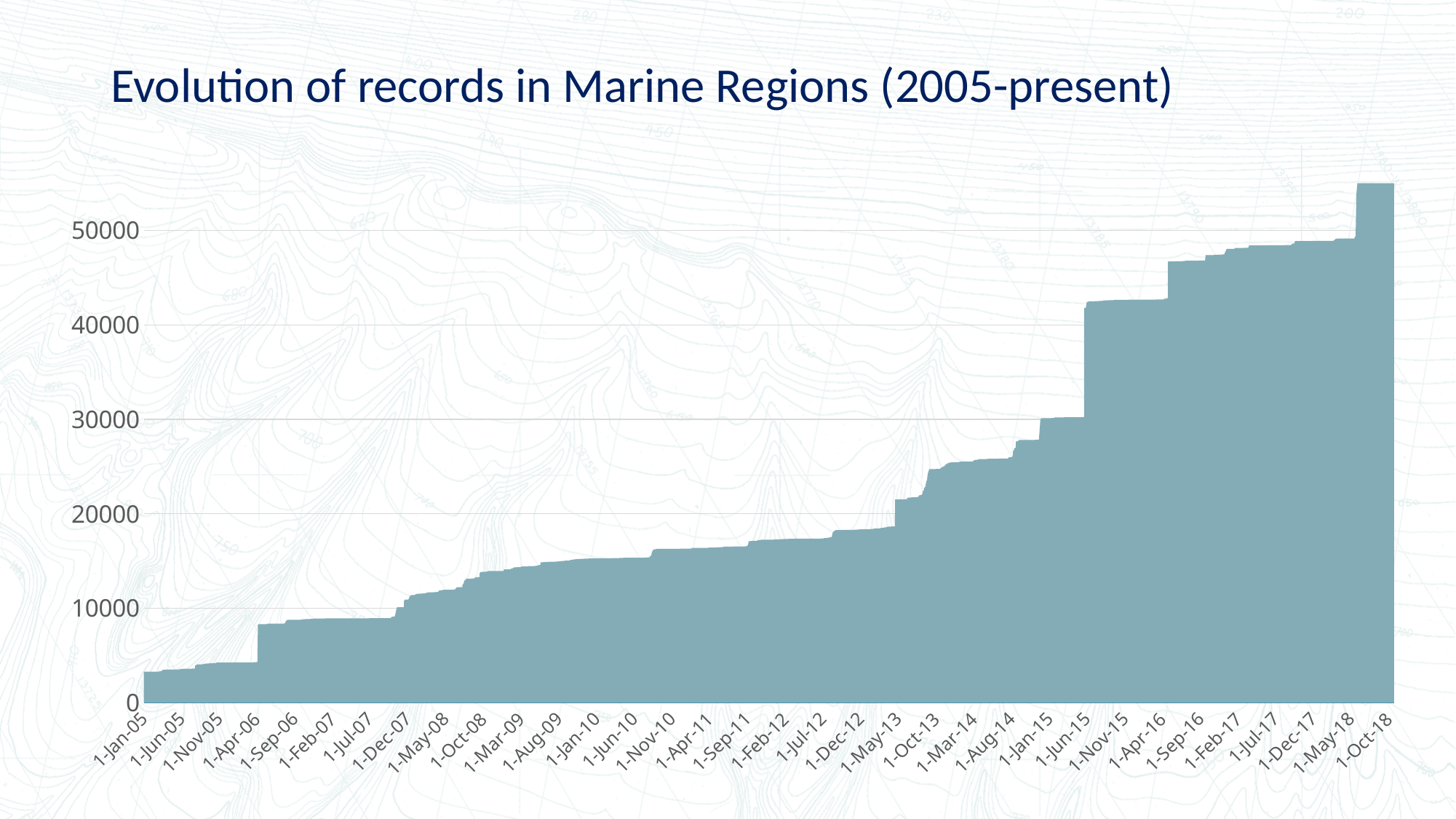
Is the value at 1-Jan-05 greater or less than 10000? less Do the values rise or fall along the x axis from 1-Jan-05 to 1-Oct-18? Rise What is the highest value labelled on the y axis? 50000 What kind of chart is shown on the slide? Area chart Is the value at 1-Mar-14 greater or less than 30000? less What is the title of the chart? Evolution of records in Marine Regions (2005-present) Which has the larger value, 1-Sep-06 or 1-Apr-16? 1-Apr-16 At which date on the x axis is the number of records lowest? 1-Jan-05 Is the value at 1-Jan-10 greater or less than 20000? less At which date on the x axis is the number of records highest? 1-Oct-18